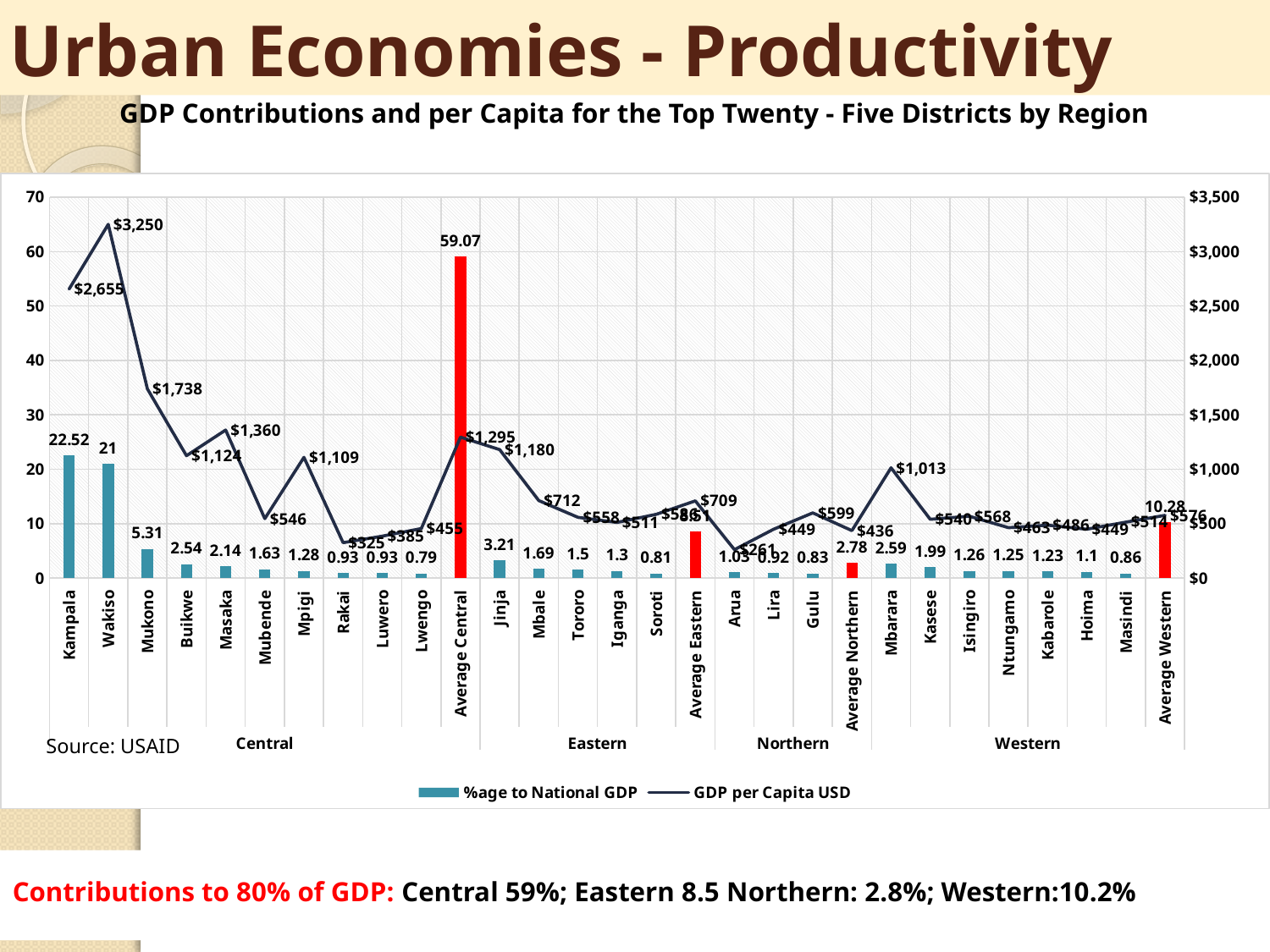
What is the GDP per capita USD for Mbarara? $1,013 How many series does the legend list? 2 Which has a larger %age to National GDP, Jinja or Mbarara? Jinja What is the value of the Average Central bar for %age to National GDP? 59.07 Which district has the highest GDP per capita USD on the line? Wakiso What is the GDP per capita in USD for Wakiso? $3,250 What is the difference in %age to National GDP between Kampala and Wakiso? 1.52 What is the value of the Average Western bar for %age to National GDP? 10.28 Is the GDP per capita for Mukono greater or less than $1,500? greater What percentage of national GDP does Kampala contribute? 22.52 What kind of chart is shown on the slide? Combination bar and line chart Which district has the lowest GDP per capita USD on the line? Arua